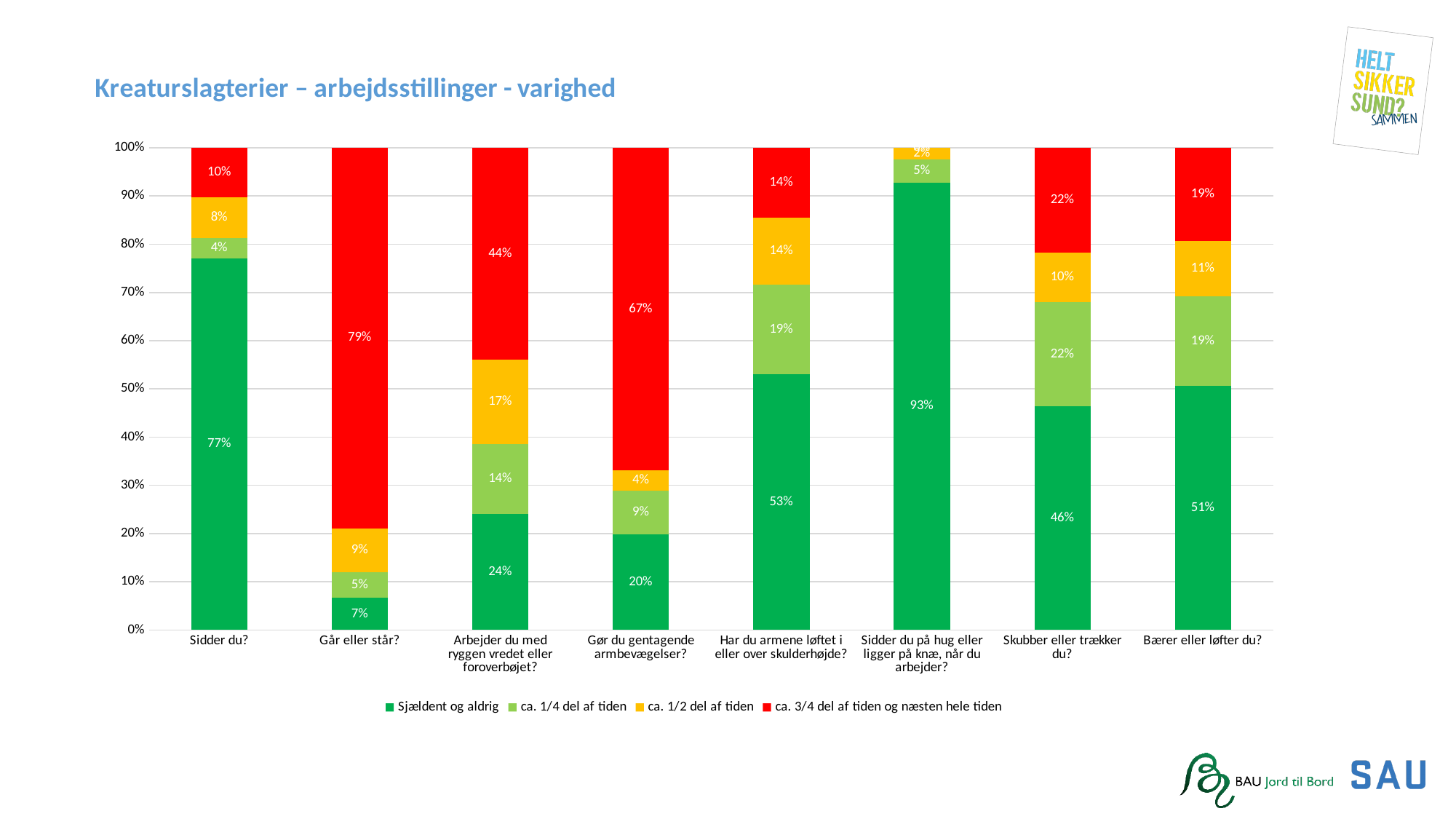
What is the title of the chart? Kreaturslagterier – arbejdsstillinger - varighed How many categories (questions) are shown along the x axis? 8 Which category has the highest 'Sjældent og aldrig' value? Sidder du på hug eller ligger på knæ, når du arbejder? What is the difference between the 'ca. 3/4 del af tiden og næsten hele tiden' values for 'Går eller står?' and 'Gør du gentagende armbevægelser?'? 12% What is the 'Sjældent og aldrig' value for 'Sidder du?'? 77% What kind of chart is shown on the slide? Stacked bar chart What is the 'ca. 1/4 del af tiden' value for 'Skubber eller trækker du?'? 22% How many series does the legend list? 4 Which is larger: the 'Sjældent og aldrig' value for 'Har du armene løftet i eller over skulderhøjde?' or for 'Bærer eller løfter du?'? Har du armene løftet i eller over skulderhøjde? What is the 'ca. 1/2 del af tiden' value for 'Arbejder du med ryggen vredet eller foroverbøjet?'? 17% Which category has the lowest 'Sjældent og aldrig' value? Går eller står? What is the 'ca. 3/4 del af tiden og næsten hele tiden' value for 'Går eller står?'? 79%